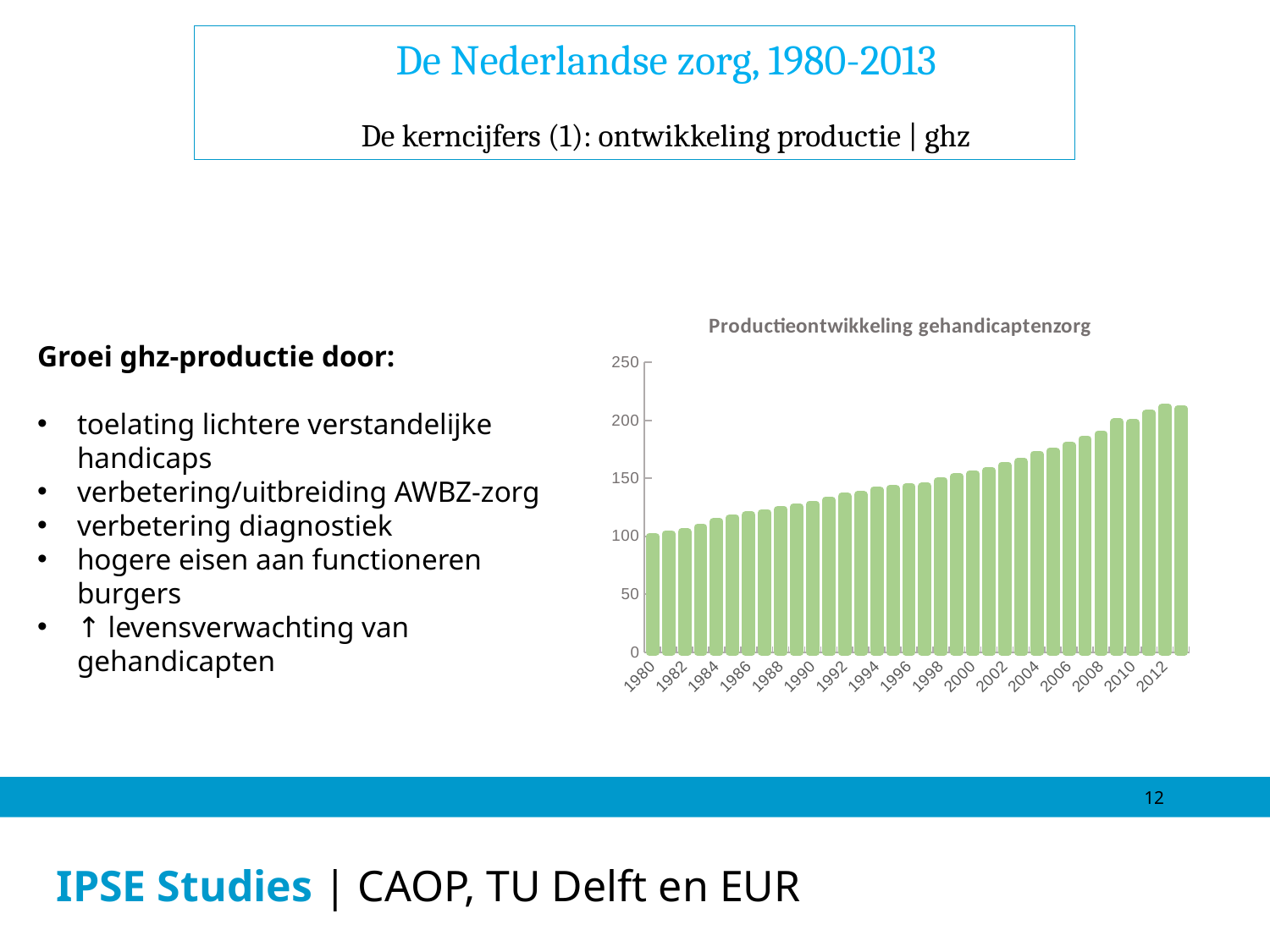
Is the value for 1990 greater or less than 150? less Which year has the larger value, 1984 or 2000? 2000 Is the value for 2012 greater or less than 200? greater Is the value for 1986 greater or less than 100? greater What is the title of the chart? Productieontwikkeling gehandicaptenzorg Which year has the larger value, 1990 or 2010? 2010 Do the values in the chart rise or fall from 1980 to 2013? rise Which year has the lowest value in the chart? 1980 What kind of chart is shown on the slide? bar chart What is the highest value shown on the vertical axis of the chart? 250